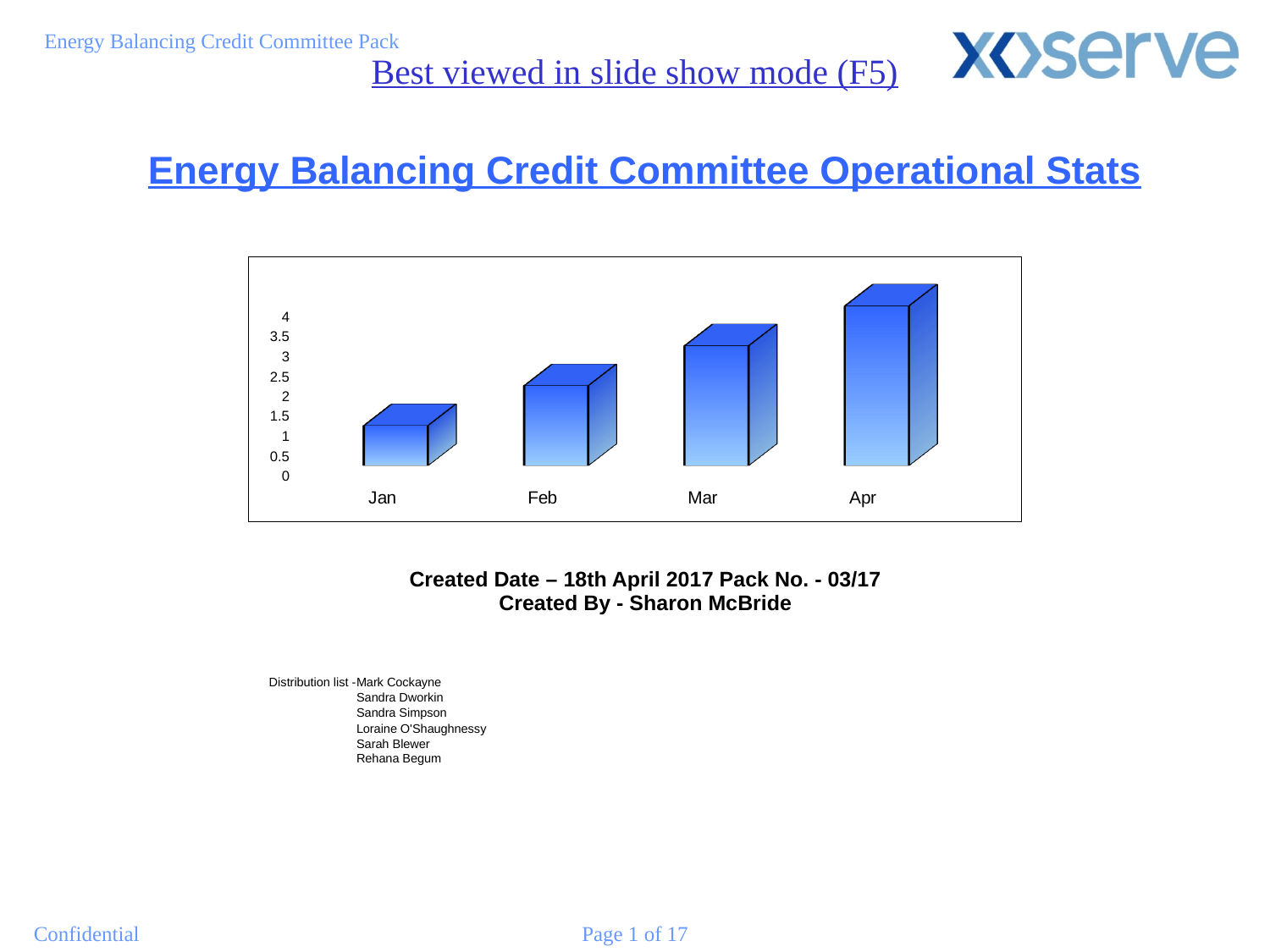
What kind of chart is shown on the slide? bar chart Is the value for Feb greater or less than 1? greater Is the value for Mar greater or less than 2? greater How many categories are shown on the x axis of the chart? 4 Is the value for Jan greater or less than 2? less Which is larger, the value for Feb or the value for Mar? Mar Which month has the lowest bar in the chart? Jan Which is larger, the value for Jan or the value for Apr? Apr What is the highest tick value shown on the vertical axis of the chart? 4 Which month has the highest bar in the chart? Apr Do the values rise or fall from Jan to Apr? rise